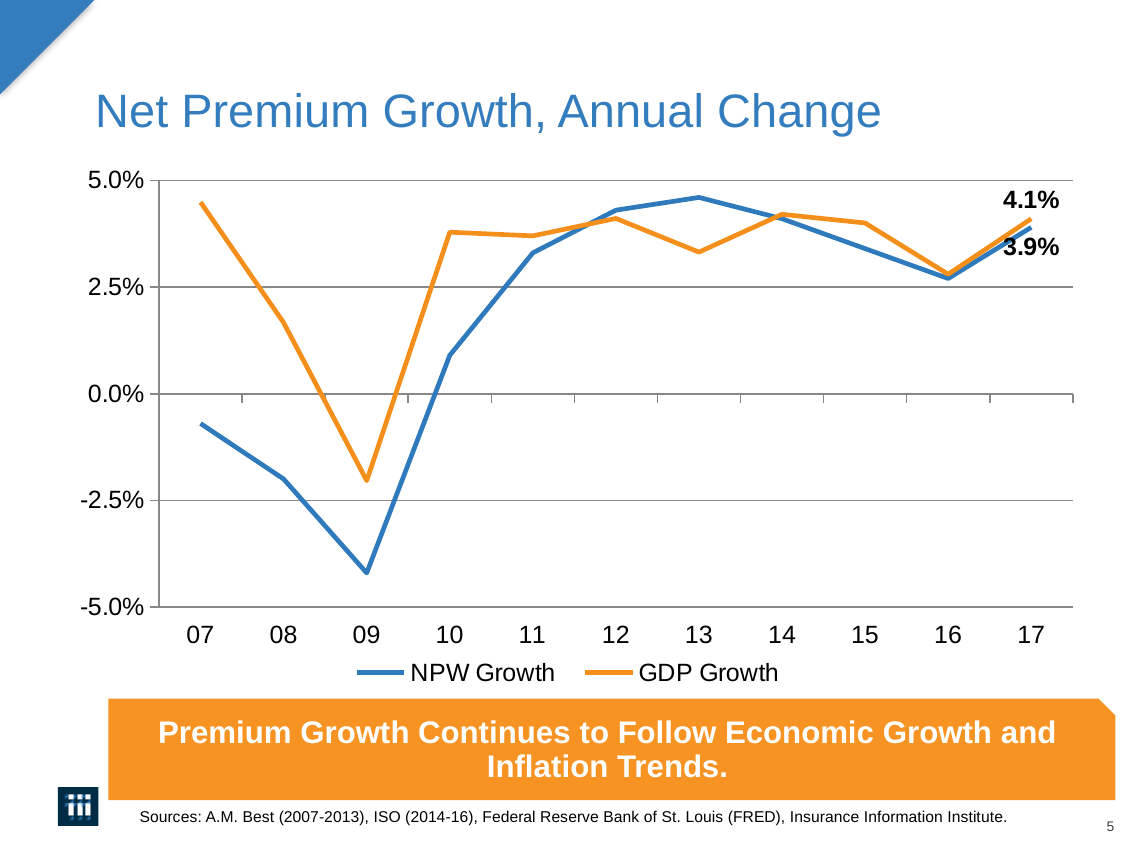
Is the GDP Growth value for 10 greater or less than 2.5%? greater What is the GDP Growth value for 17? 4.1% How many years are plotted along the x axis? 11 What is the NPW Growth value for 17? 3.9% How many series does the legend list? 2 In 17, which series has the larger value, NPW Growth or GDP Growth? GDP Growth In which year is NPW Growth at its lowest? 09 What kind of chart is shown on the slide? line chart Is the NPW Growth value for 09 greater or less than -2.5%? less What is the difference between GDP Growth and NPW Growth in 17? 0.2% Does NPW Growth rise or fall from 09 to 13? rise In which year is NPW Growth at its highest? 13